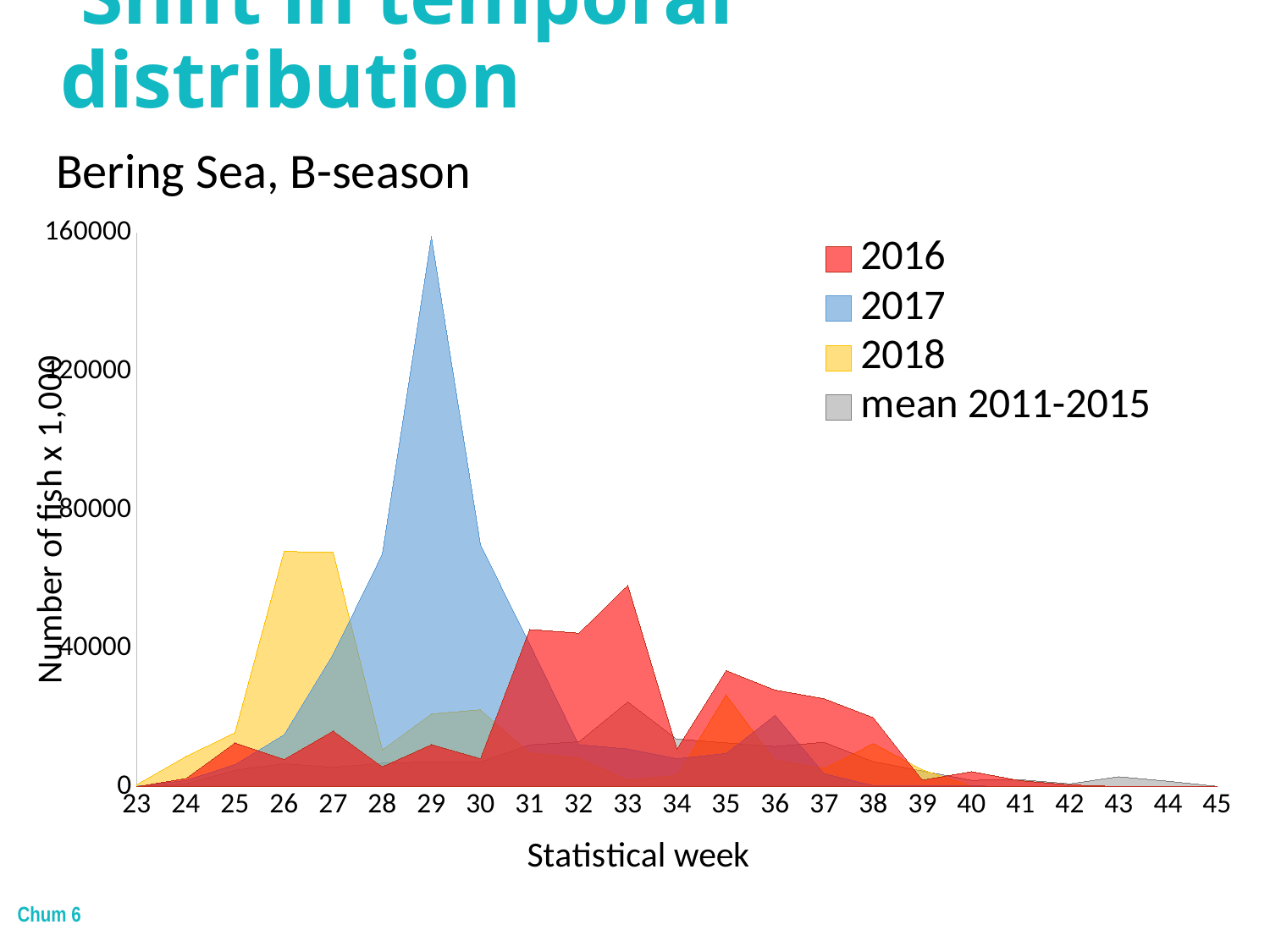
Is the value for 2016 in week 33 greater or less than 80000? less What kind of chart is shown on the slide? area chart Which colour represents the mean 2011-2015 series in the legend? gray In which statistical week does the 2017 series reach its peak? 29 Is the value for 2017 in week 29 greater or less than 120000? greater Do the 2016 values rise or fall from week 33 to week 39? fall How many series does the legend list? 4 How many statistical weeks are labelled along the x axis? 23 Is the value for 2018 in week 26 greater or less than 40000? greater Which series reaches the highest value on the chart? 2017 Which is larger: the 2017 value in week 29 or the 2018 value in week 26? 2017 value in week 29 What is the title of the x axis? Statistical week